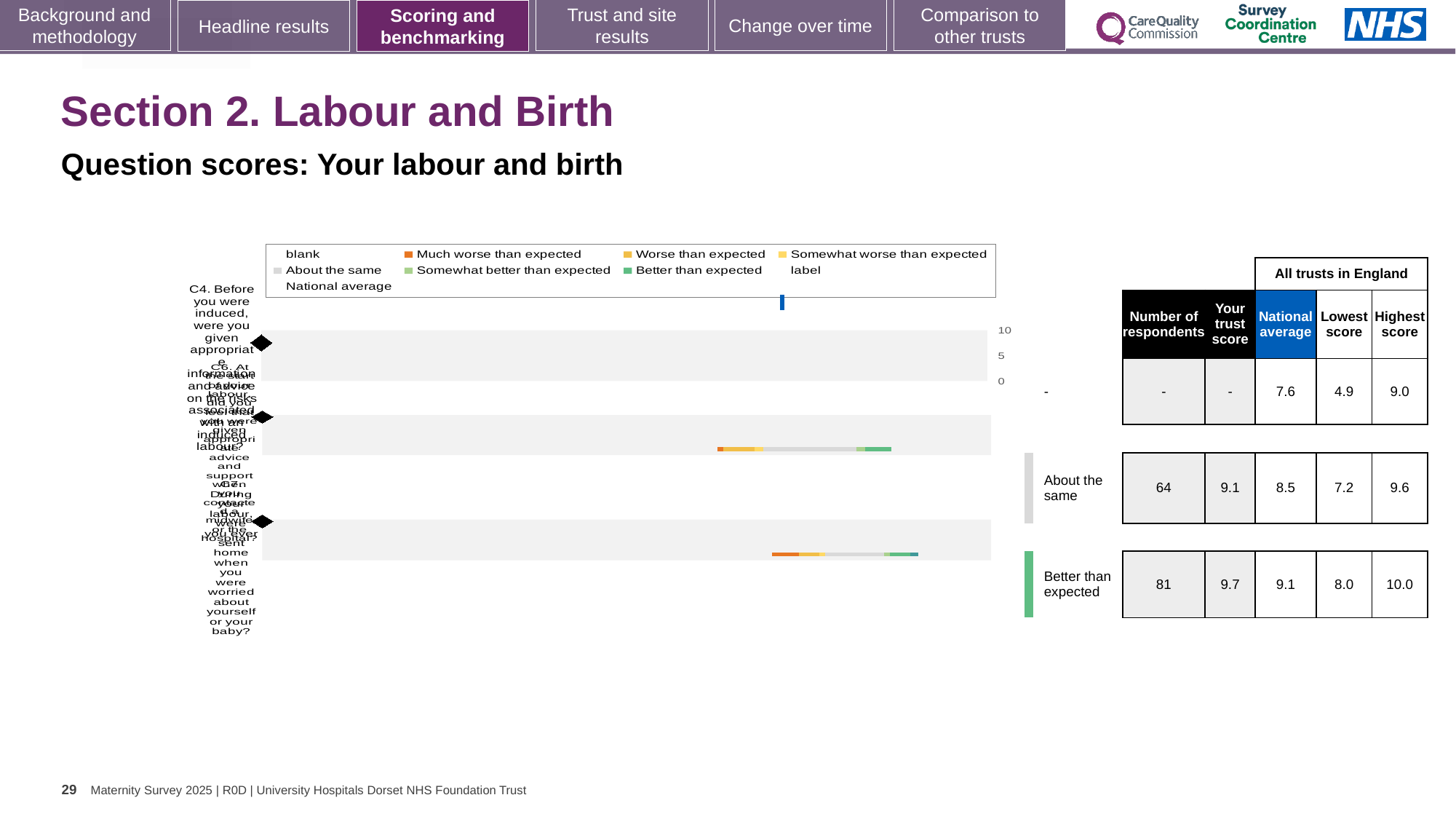
What is the highest tick value shown on the chart's numeric axis? 10 What kind of chart is shown on the slide? bar chart In the table beside the chart, how many respondents are listed for the row rated 'About the same'? 64 In the table beside the chart, which row has the highest number of respondents? Better than expected In the table beside the chart, which row has the larger trust score: 'About the same' or 'Better than expected'? Better than expected In the table beside the chart, what is the lowest score in the first row (the row with no rating)? 4.9 In the table beside the chart, what is the difference between the trust scores of the 'Better than expected' row and the 'About the same' row? 0.6 Which legend entry is listed first in the chart's legend? blank In the table beside the chart, what is the national average in the first row (the row with no rating)? 7.6 In the table beside the chart, what is the highest score for the row rated 'Better than expected'? 10.0 In the table beside the chart, what is the national average for the row rated 'About the same'? 8.5 In the table beside the chart, what is the trust score for the row rated 'Better than expected'? 9.7